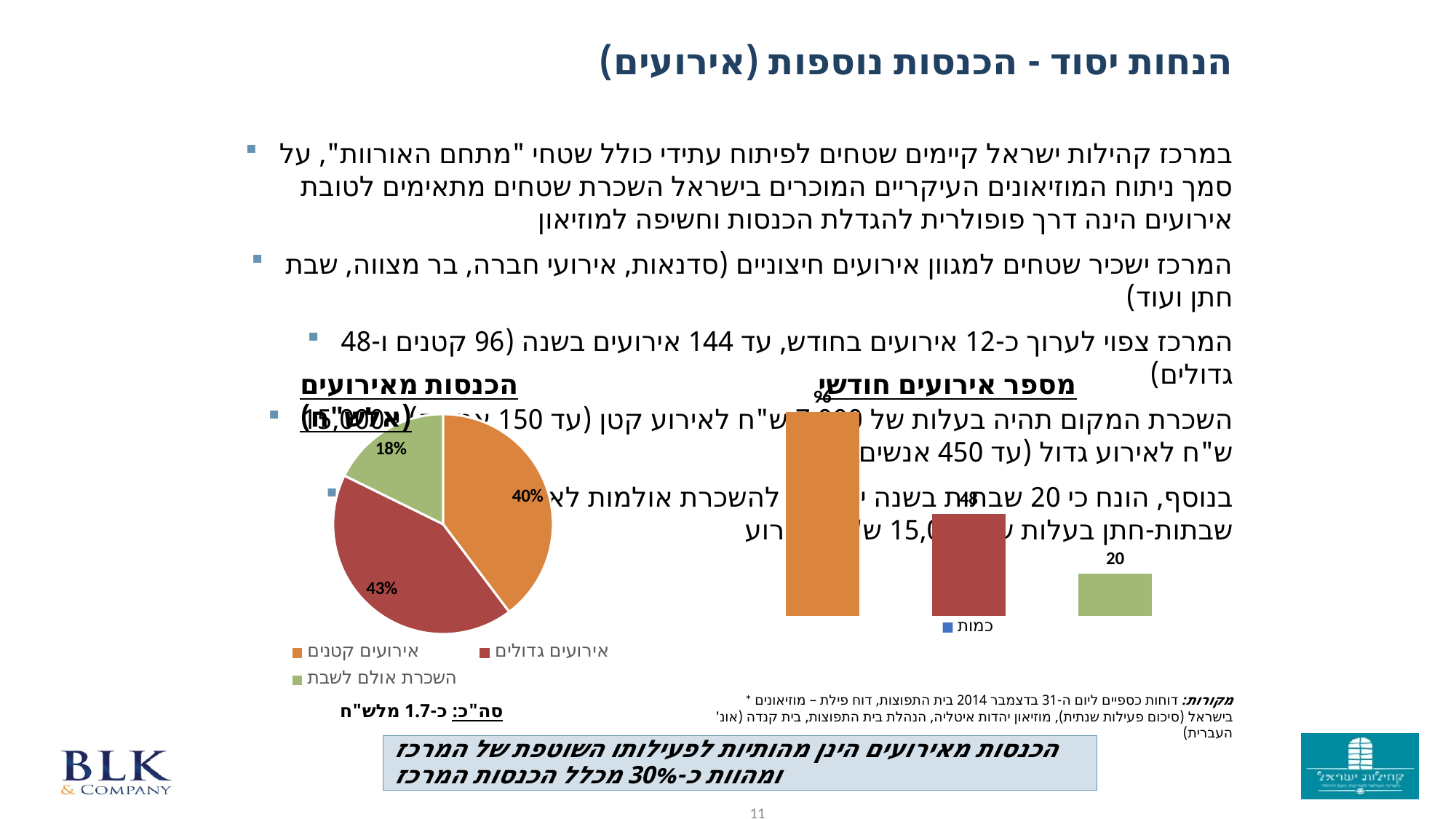
What kind of chart is the chart titled "הכנסות מאירועים"? Pie chart In the bar chart titled "מספר אירועים חודשי", how many series does the legend list? 1 In the bar chart titled "מספר אירועים חודשי", how many bars are plotted? 3 In the bar chart titled "מספר אירועים חודשי", what is the value labelled on the rightmost (green) bar? 20 In the pie chart titled "הכנסות מאירועים", what share is labelled for השכרת אולם לשבת? 18% What kind of chart is the chart titled "מספר אירועים חודשי"? Bar chart In the pie chart titled "הכנסות מאירועים", which category has the smallest slice? השכרת אולם לשבת In the pie chart titled "הכנסות מאירועים", what share is labelled for אירועים גדולים? 43% In the pie chart titled "הכנסות מאירועים", what share is labelled for אירועים קטנים? 40% In the pie chart titled "הכנסות מאירועים", how many slices are there? 3 In the pie chart titled "הכנסות מאירועים", by how many percentage points does אירועים גדולים exceed אירועים קטנים? 3 percentage points In the pie chart titled "הכנסות מאירועים", which category has the largest slice? אירועים גדולים